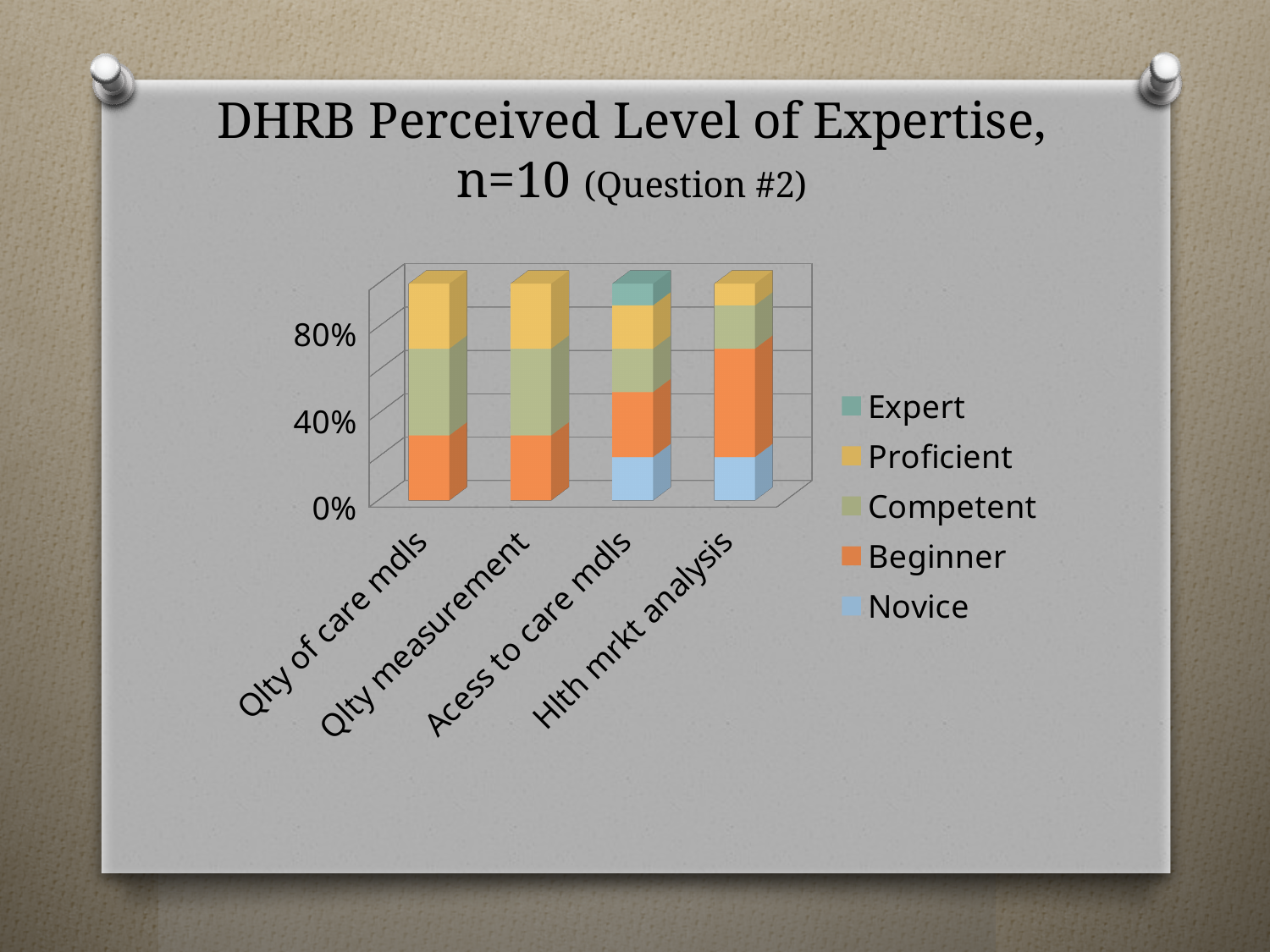
What is the title of the chart on the slide? DHRB Perceived Level of Expertise, n=10 (Question #2) How many categories are shown along the x axis of the chart? 4 Is the Beginner value for Hlth mrkt analysis greater or less than 40%? greater What kind of chart is shown on the slide? Stacked bar chart Is the Beginner value for Qlty of care mdls greater or less than 40%? less Which is larger, the Proficient segment for Qlty of care mdls or the Proficient segment for Hlth mrkt analysis? Qlty of care mdls Which category has the largest Beginner segment? Hlth mrkt analysis How many series does the chart's legend list? 5 Which series is shown in the topmost position of the legend? Expert Which category has the smallest Proficient segment? Hlth mrkt analysis Which category is the only one with an Expert segment? Acess to care mdls Which is larger, the Beginner segment for Hlth mrkt analysis or the Beginner segment for Qlty measurement? Hlth mrkt analysis